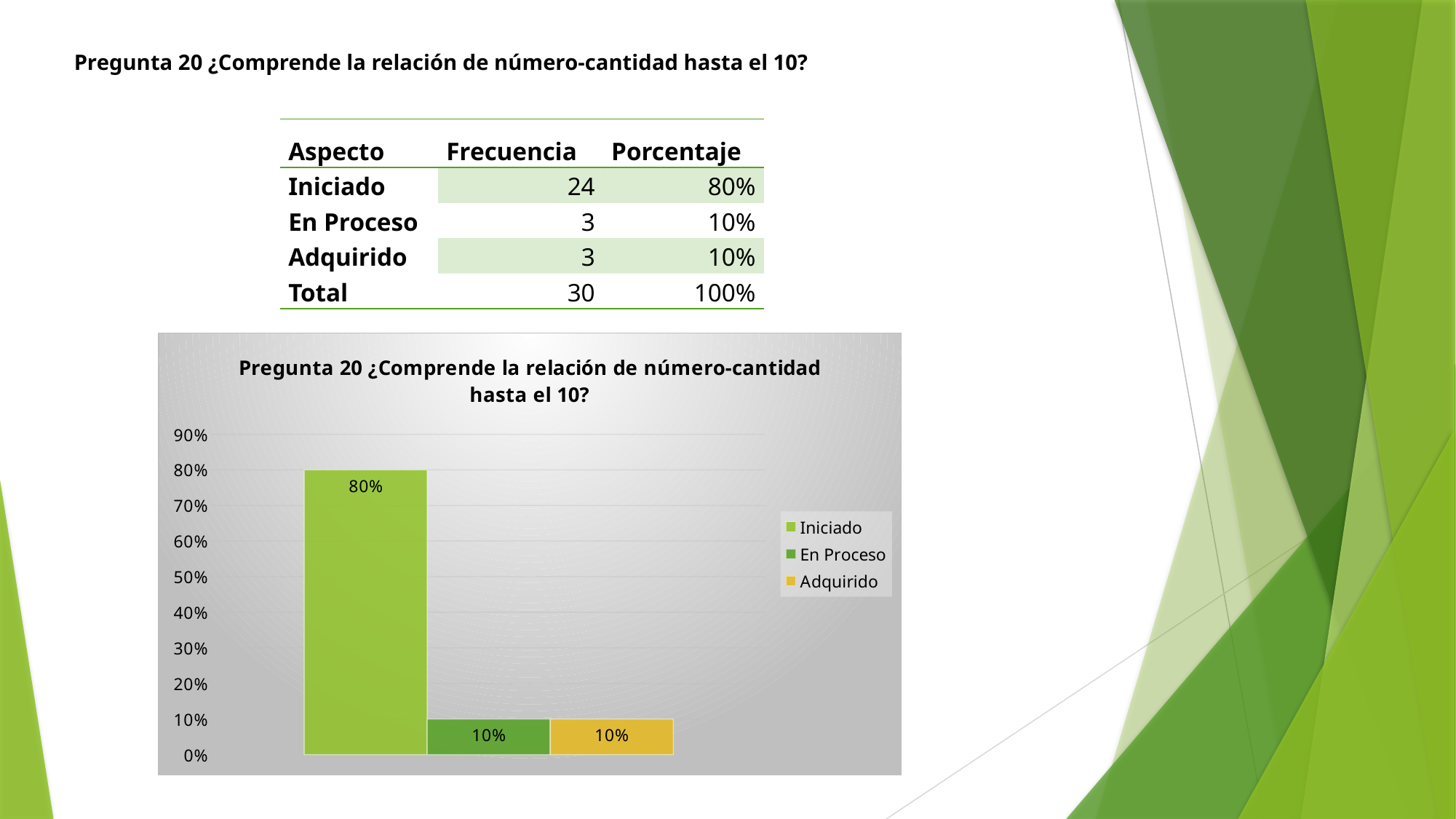
How many series does the legend list? 3 What colour is the bar for Adquirido? yellow What is the value shown for Iniciado in the chart? 80% What is the value shown for En Proceso in the chart? 10% Which series has the highest value in the chart? Iniciado What is the difference between the values for Iniciado and En Proceso? 70% What is the value shown for Adquirido in the chart? 10% What is the title of the chart? Pregunta 20 ¿Comprende la relación de número-cantidad hasta el 10? What kind of chart is shown on the slide? bar chart Is the value for Iniciado greater or less than 50%? greater Is the value for En Proceso greater or less than 20%? less Which is larger, the value for Iniciado or the value for Adquirido? Iniciado